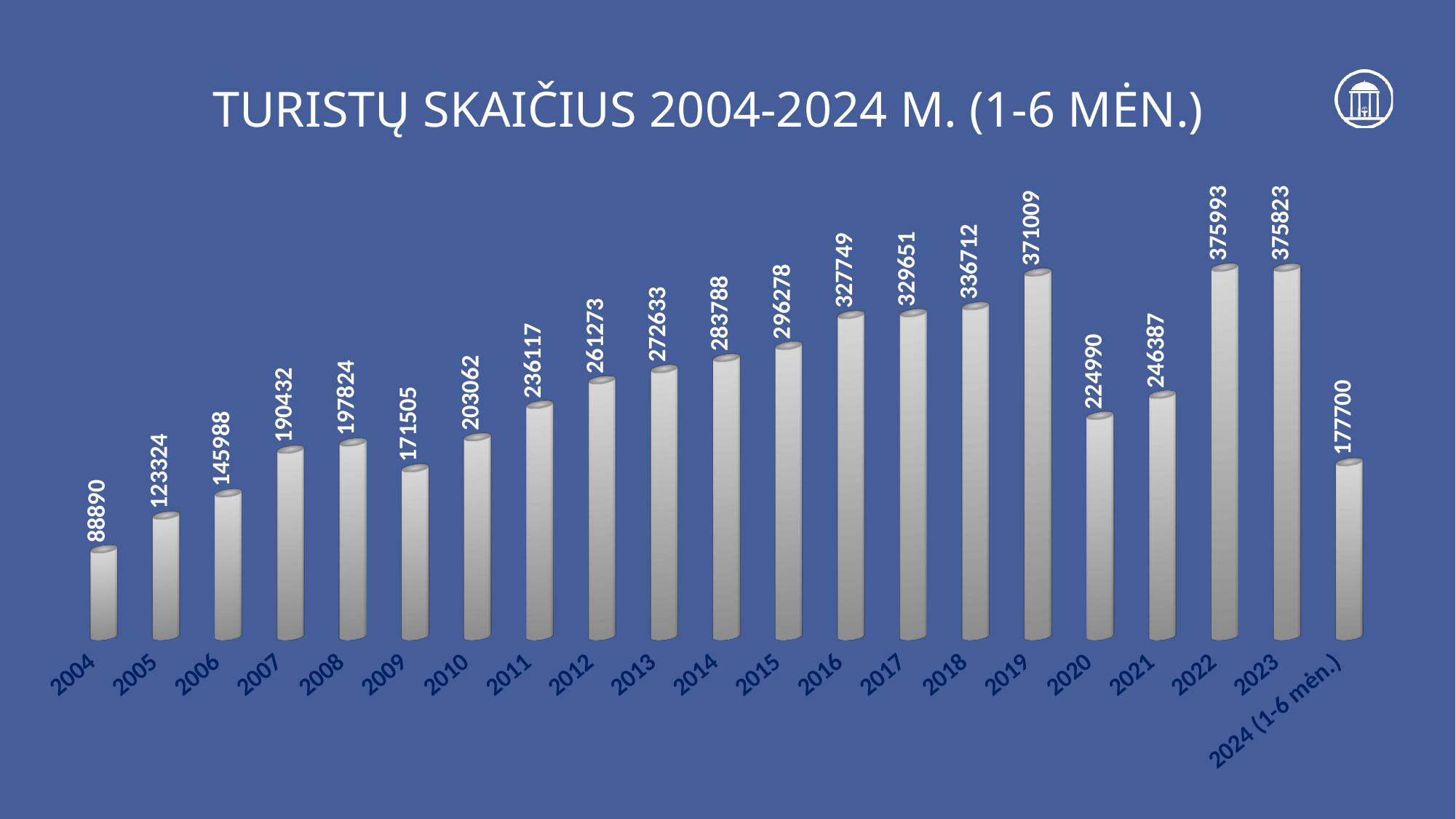
How many bars are shown in the chart? 21 Which is larger, the value for 2008 or the value for 2009? 2008 What is the difference between the values for 2005 and 2004? 34434 What is the value for 2019? 371009 What is the value for 2004? 88890 Which year has the lowest value? 2004 Do the values rise or fall from 2010 to 2019? rise What is the value for 2024 (1-6 mėn.)? 177700 What kind of chart is shown on the slide? bar chart What is the value for 2013? 272633 What is the difference between the values for 2019 and 2020? 146019 Which is larger, the value for 2020 or the value for 2021? 2021